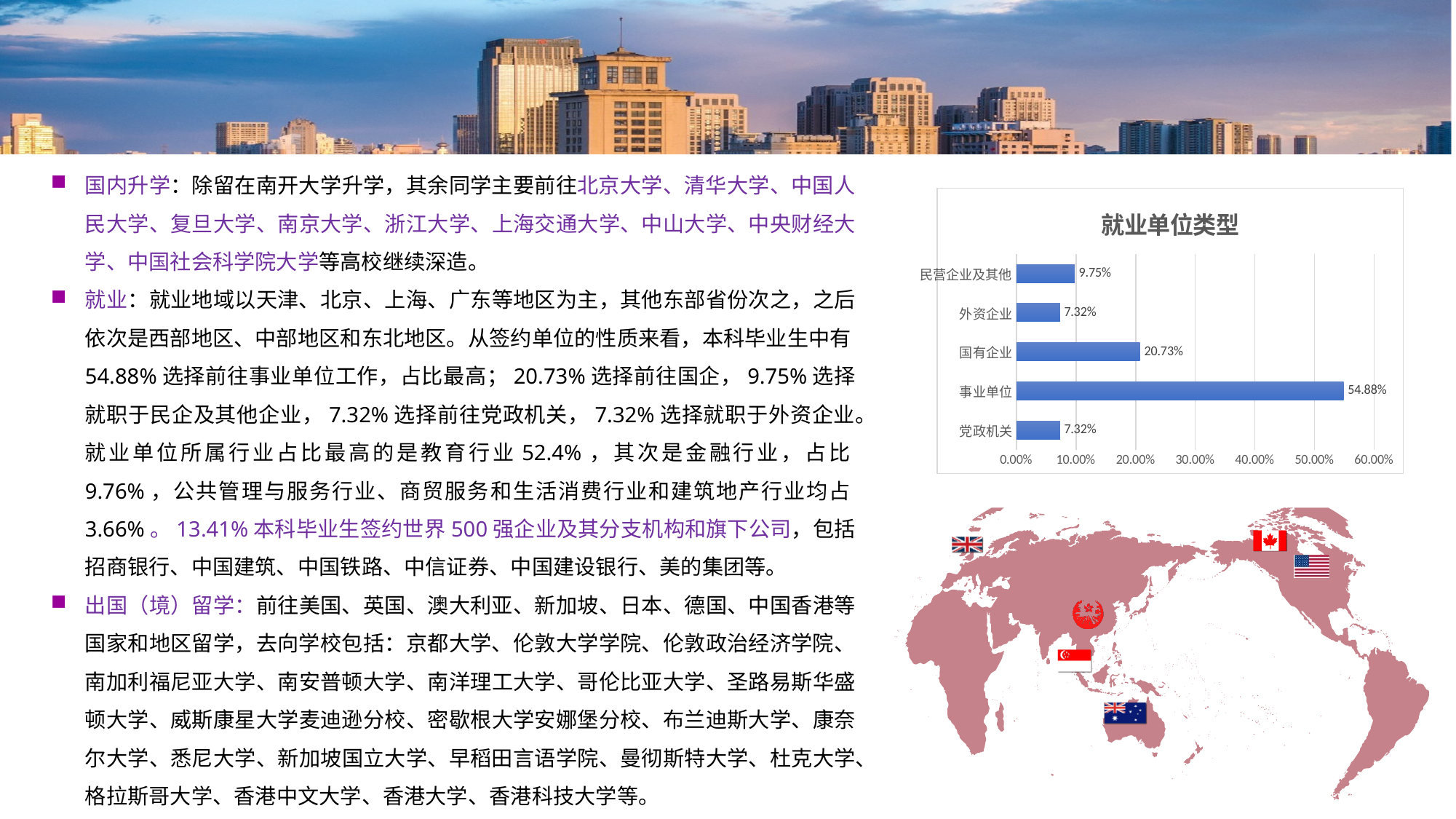
What is the difference between the values for 民营企业及其他 and 外资企业? 2.43% What is the value for 民营企业及其他? 9.75% What is the difference between the values for 事业单位 and 国有企业? 34.15% What is the title of the chart? 就业单位类型 Which category has the highest value? 事业单位 What is the value for 党政机关? 7.32% Is the value for 事业单位 greater or less than 50.00%? greater How many categories are shown in the chart? 5 Which is larger, the value for 国有企业 or the value for 民营企业及其他? 国有企业 What is the value for 国有企业? 20.73% What is the value for 事业单位? 54.88% What type of chart is shown on the slide? bar chart